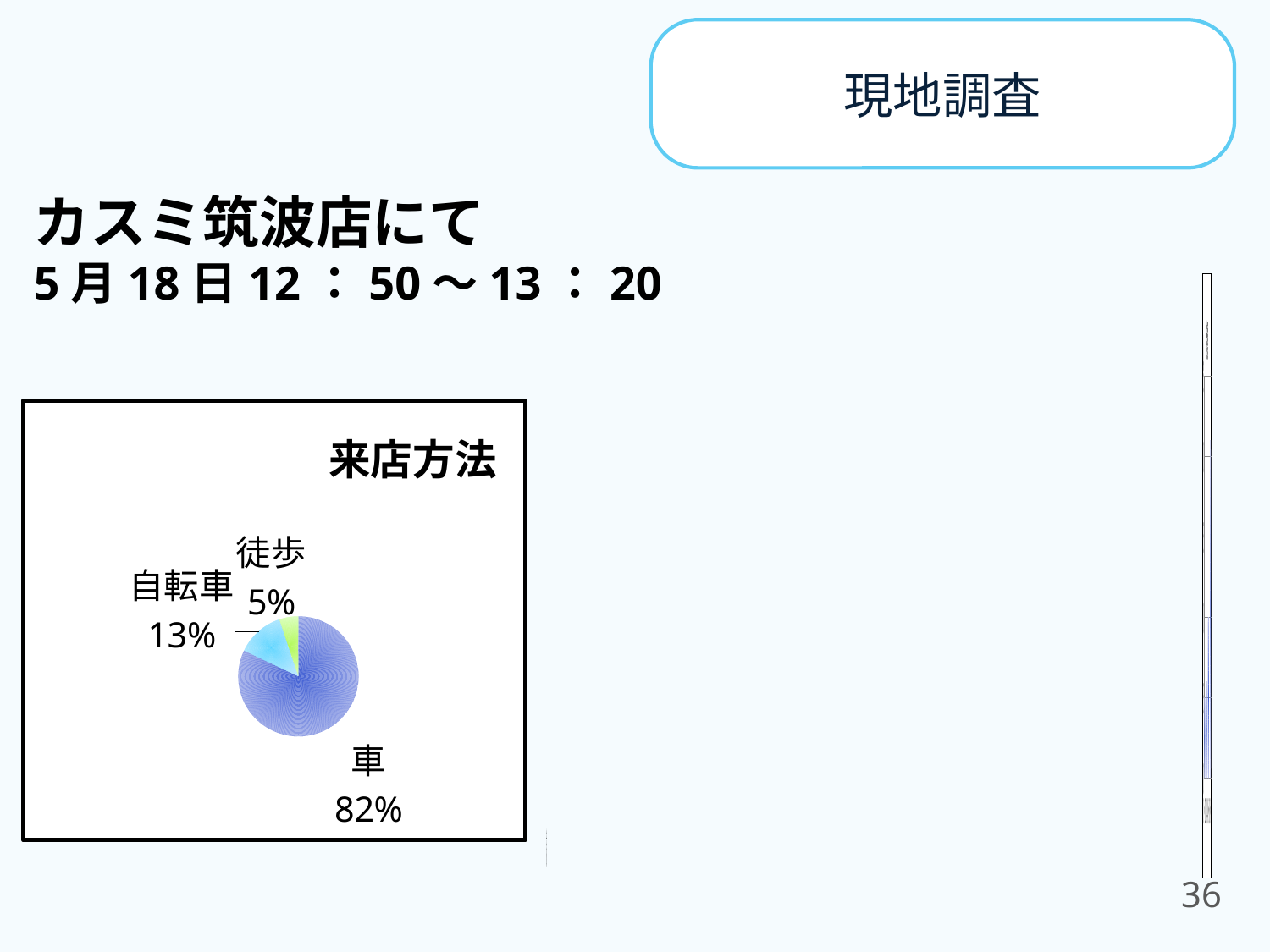
What share of the pie does 徒歩 have? 5% What share of the pie does 車 have? 82% What is the difference between the share for 自転車 and the share for 徒歩? 8% Which category has the largest slice of the pie? 車 What kind of chart is shown on the slide? pie chart Which category has the smallest slice of the pie? 徒歩 What share of the pie does 自転車 have? 13% What is the difference between the share for 車 and the share for 自転車? 69% What is the title of the chart? 来店方法 How many categories are shown in the pie chart? 3 Which is larger, the share for 自転車 or the share for 徒歩? 自転車 What is the combined share of 自転車 and 徒歩? 18%